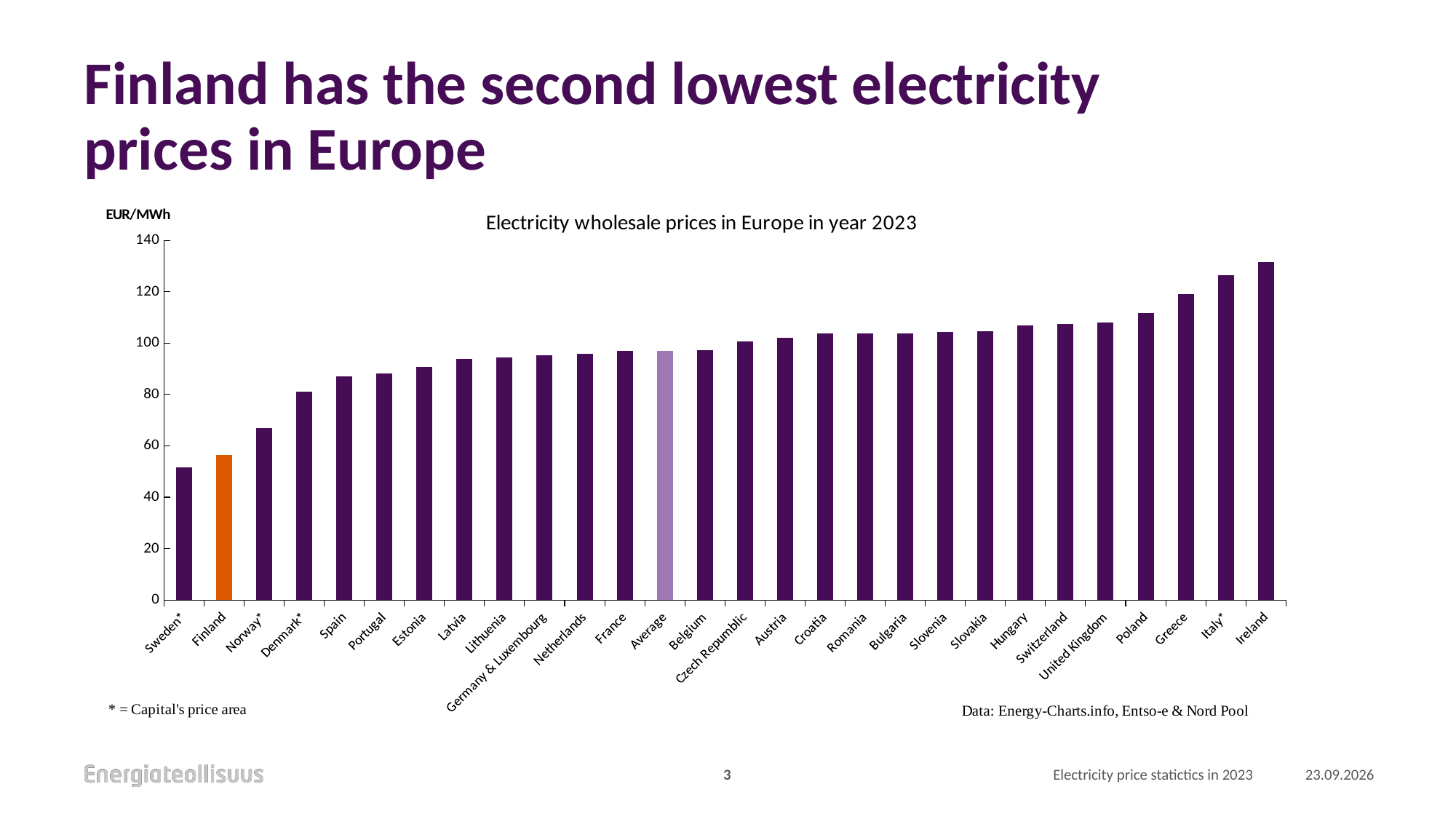
Is the value for Norway* greater or less than 60? greater Which country has the highest electricity wholesale price in the chart? Ireland Is the value for Ireland greater or less than 120? greater Is the value for Poland greater or less than 100? greater Which has a higher electricity wholesale price, Finland or Norway*? Norway* How many bars are plotted in the chart? 28 What is the title of the chart? Electricity wholesale prices in Europe in year 2023 Which country has the lowest electricity wholesale price in the chart? Sweden* Do the values rise or fall from left to right along the x axis? rise What type of chart is shown on the slide? bar chart